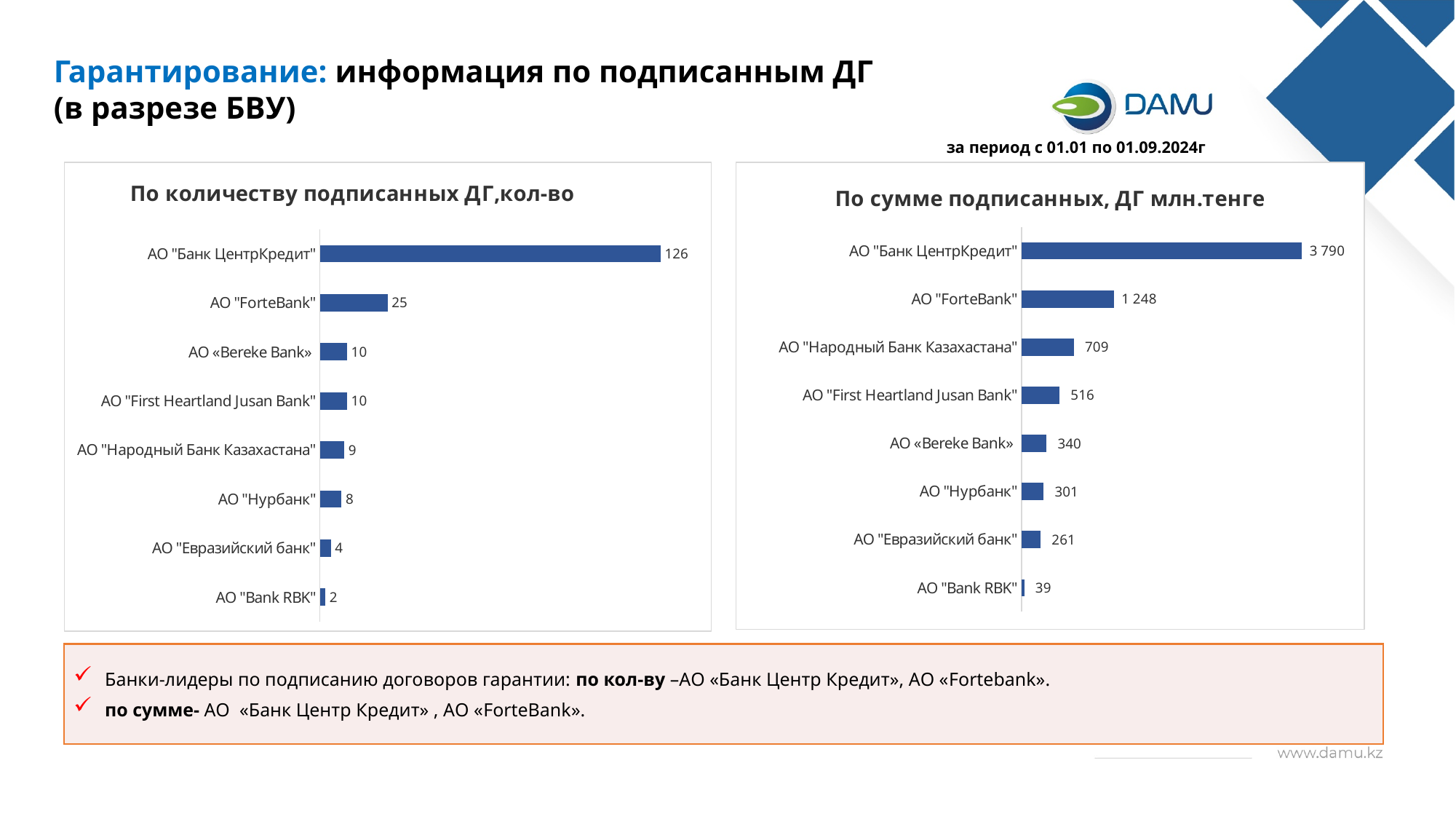
In the chart "По количеству подписанных ДГ,кол-во", what is the difference between АО "Банк ЦентрКредит" and АО "ForteBank"? 101 In the chart "По сумме подписанных, ДГ млн.тенге", what is the difference between АО "ForteBank" and АО "First Heartland Jusan Bank"? 732 In the chart "По сумме подписанных, ДГ млн.тенге", what is the value for АО "Банк ЦентрКредит"? 3 790 In the chart "По сумме подписанных, ДГ млн.тенге", which bank has the lowest value? АО "Bank RBK" How many banks are shown in the chart "По количеству подписанных ДГ,кол-во"? 8 In the chart "По количеству подписанных ДГ,кол-во", which bank has the highest value? АО "Банк ЦентрКредит" In the chart "По сумме подписанных, ДГ млн.тенге", what is the value for АО "Народный Банк Казахастана"? 709 What type of chart is "По сумме подписанных, ДГ млн.тенге"? Bar chart In the chart "По количеству подписанных ДГ,кол-во", what is the value for АО "ForteBank"? 25 What period is stated on the slide for the data in the charts? с 01.01 по 01.09.2024г In the chart "По количеству подписанных ДГ,кол-во", what is the value for АО "Bank RBK"? 2 In the chart "По сумме подписанных, ДГ млн.тенге", which is larger: АО «Bereke Bank» or АО "Нурбанк"? АО «Bereke Bank»